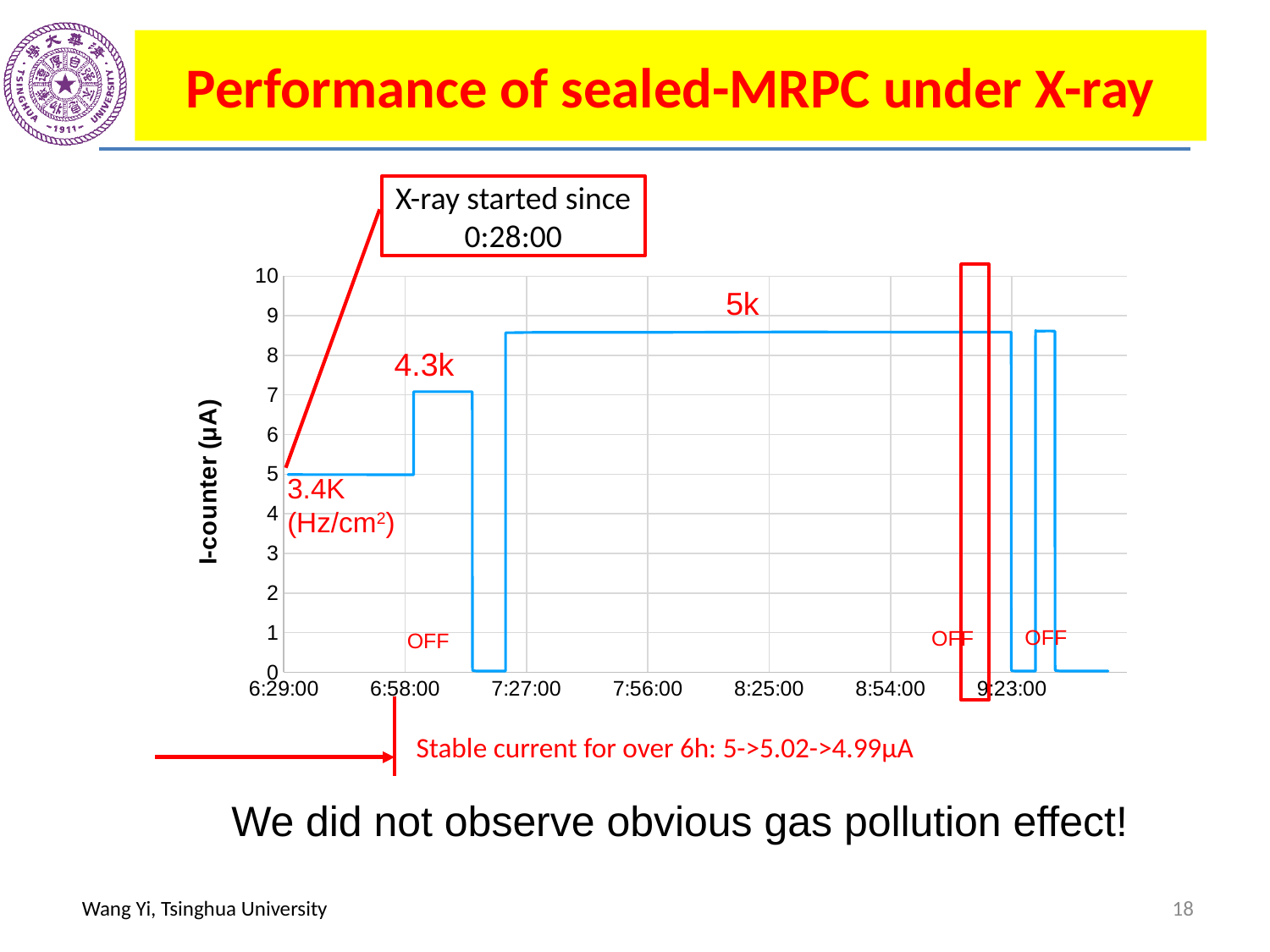
What is the label of the y-axis? I-counter (µA) Is the current value at 8:25:00 greater or less than 8? greater Is the current value on the plateau labelled 4.3k greater or less than 6? greater Which plateau has the higher current: the one labelled 4.3k or the one labelled 5k? 5k What is the first time label on the x-axis? 6:29:00 Is the current value at 7:56:00 greater or less than 9? less How many time labels are shown on the x-axis? 7 Is the current at 8:25:00 higher or lower than the current at 6:29:00? higher What is the maximum value shown on the y-axis? 10 What type of chart is shown on the slide? line chart